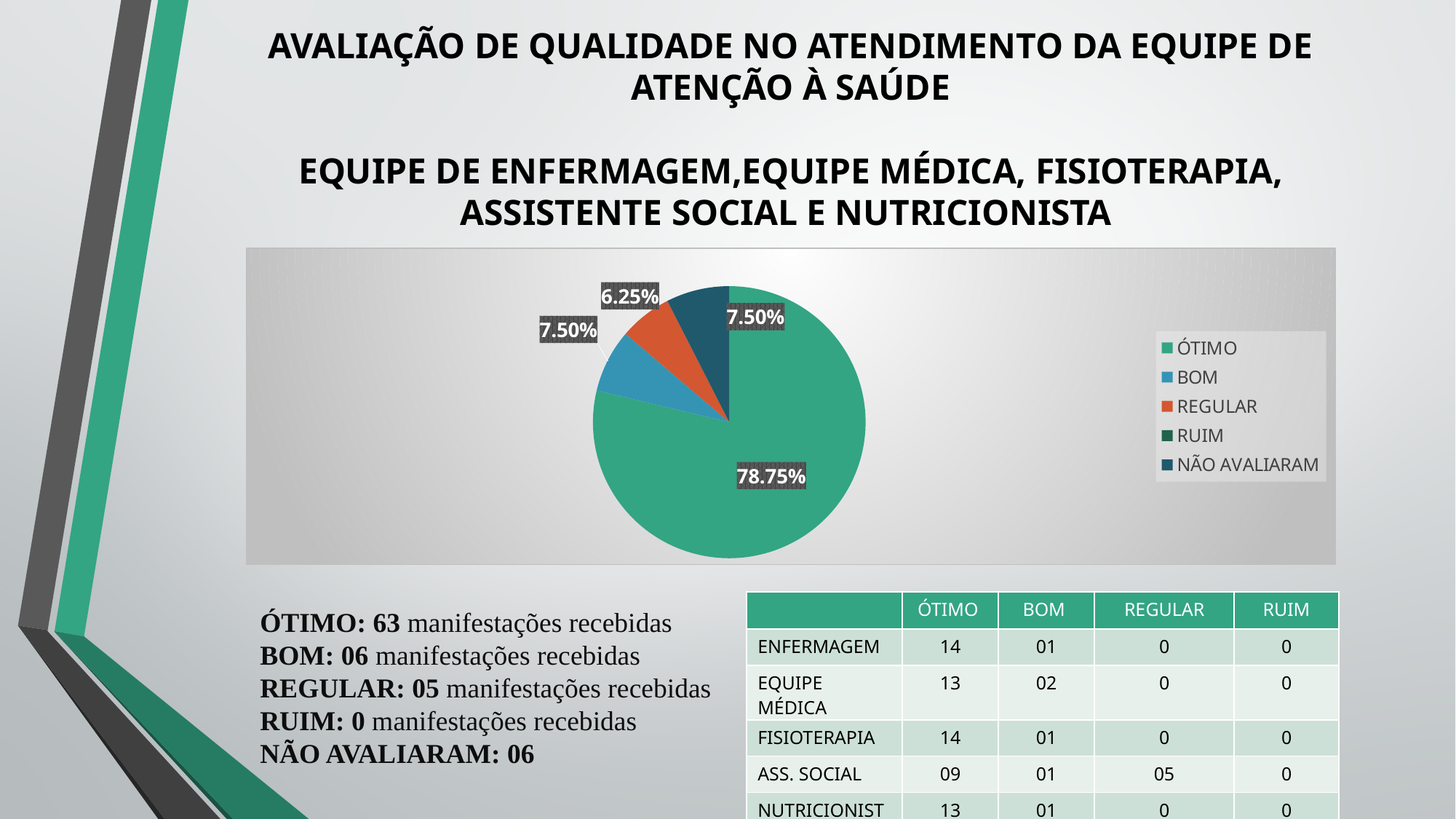
What kind of chart is shown on the slide? pie chart What is the difference between the ÓTIMO share and the BOM share? 71.25% What share of the pie does REGULAR represent? 6.25% What share of the pie does NÃO AVALIARAM represent? 7.50% What share of the pie does ÓTIMO represent? 78.75% How many entries does the legend of the pie chart list? 5 What is the difference between the BOM share and the REGULAR share? 1.25% Which legend entry is shown in light blue? BOM Which category has the largest slice of the pie? ÓTIMO Which is larger in the pie chart, BOM or REGULAR? BOM Which legend entry is shown in orange? REGULAR